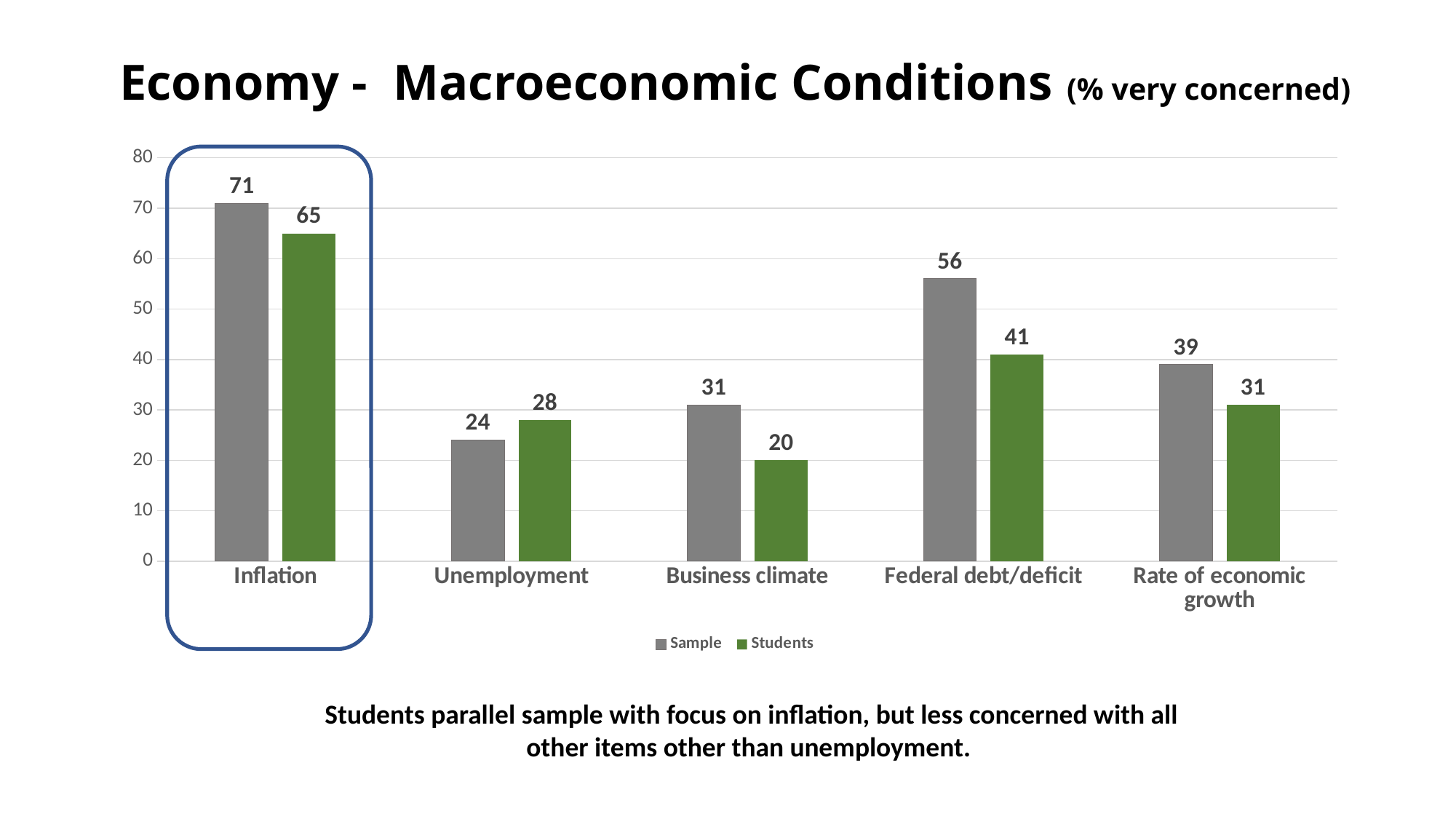
Which category is highlighted with a blue rounded outline? Inflation What is the difference between the Sample and Students values for Federal debt/deficit? 15 How many series does the legend list? 2 Is the Sample value for Rate of economic growth greater or less than 30? greater What is the Students value for Business climate? 20 Which category has the lowest Students value? Business climate What kind of chart is shown on the slide? Bar chart How many categories are shown on the x axis? 5 What is the Sample value for Inflation? 71 Which is larger for Unemployment, the Sample value or the Students value? Students Which category has the highest Sample value? Inflation What is the Students value for Federal debt/deficit? 41